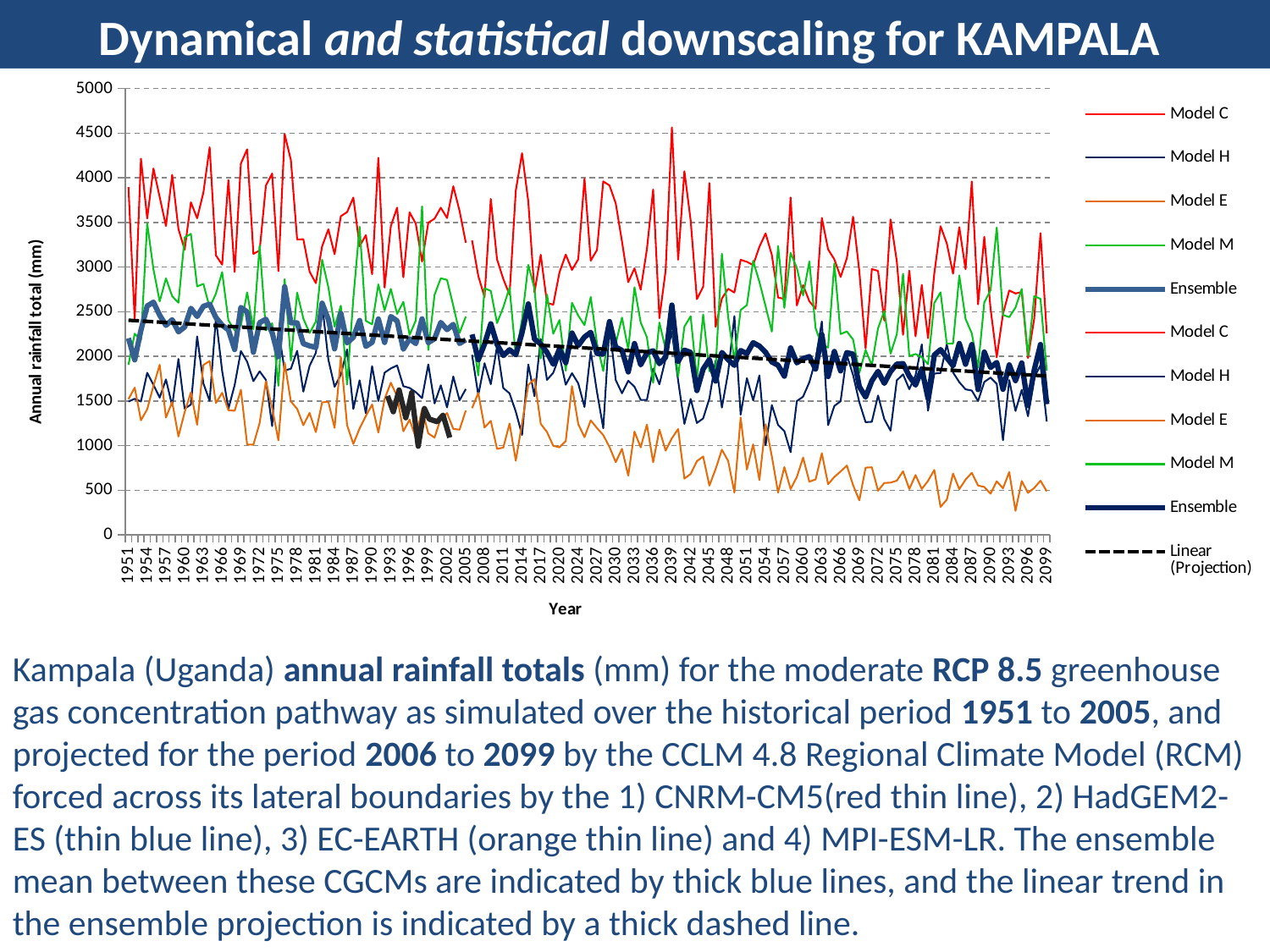
Which series reaches the highest annual rainfall total anywhere on the chart? Model C How many entries does the chart legend list? 11 What is the first year shown on the x axis of the chart? 1951 Which series has the lowest values in the final years of the chart (around 2099)? Model E Does the Linear (Projection) dashed line rise or fall from left to right across the years? fall Is the value for the Ensemble line in 1951 greater or less than 3000? less Is the value for Model C in 2039 greater or less than 4000? greater What kind of chart is shown on the slide? line chart Is the value for Model E in 2099 greater or less than 1000? less Which is larger in 2039, the value for Model C or the value for Model E? Model C What is the title of the chart's vertical axis? Annual rainfall total (mm) What colour is the Model C line in the chart? red